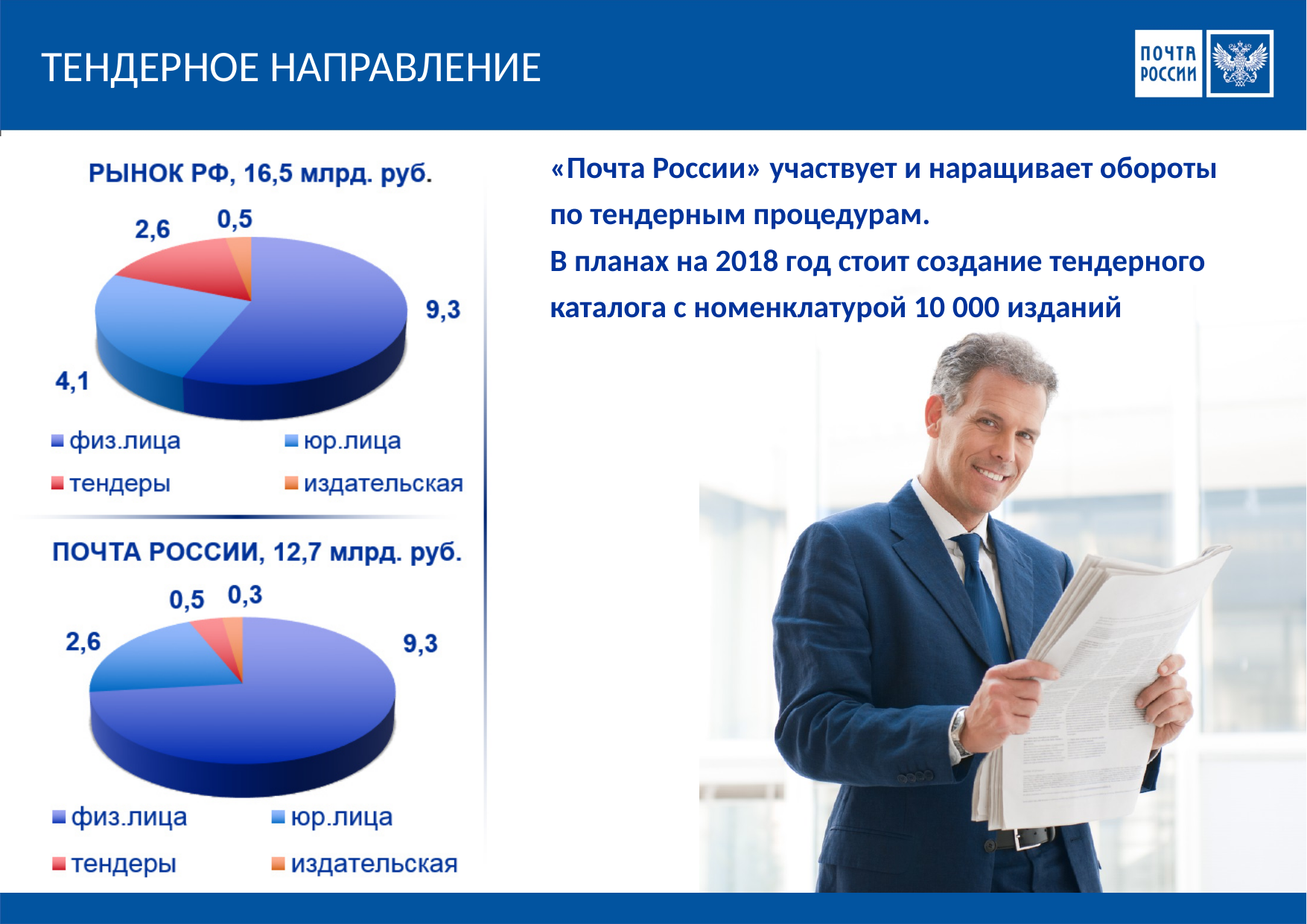
In the chart titled «ПОЧТА РОССИИ, 12,7 млрд. руб.», which category has the smallest value? издательская In the chart titled «ПОЧТА РОССИИ, 12,7 млрд. руб.», what is the value for тендеры? 0,5 In the chart titled «РЫНОК РФ, 16,5 млрд. руб.», what is the value for физ.лица? 9,3 In the chart titled «РЫНОК РФ, 16,5 млрд. руб.», what is the value for юр.лица? 4,1 In the chart titled «ПОЧТА РОССИИ, 12,7 млрд. руб.», what is the difference between the values for юр.лица and тендеры? 2,1 How many categories does the chart titled «ПОЧТА РОССИИ, 12,7 млрд. руб.» show? 4 Which is larger: the value for тендеры in the chart titled «РЫНОК РФ, 16,5 млрд. руб.» or the value for тендеры in the chart titled «ПОЧТА РОССИИ, 12,7 млрд. руб.»? РЫНОК РФ In the chart titled «РЫНОК РФ, 16,5 млрд. руб.», what is the difference between the values for физ.лица and юр.лица? 5,2 In the chart titled «РЫНОК РФ, 16,5 млрд. руб.», which colour represents тендеры? Red What kind of chart is the chart titled «РЫНОК РФ, 16,5 млрд. руб.»? Pie chart In the chart titled «ПОЧТА РОССИИ, 12,7 млрд. руб.», what is the value for издательская? 0,3 In the chart titled «РЫНОК РФ, 16,5 млрд. руб.», which category has the largest value? физ.лица